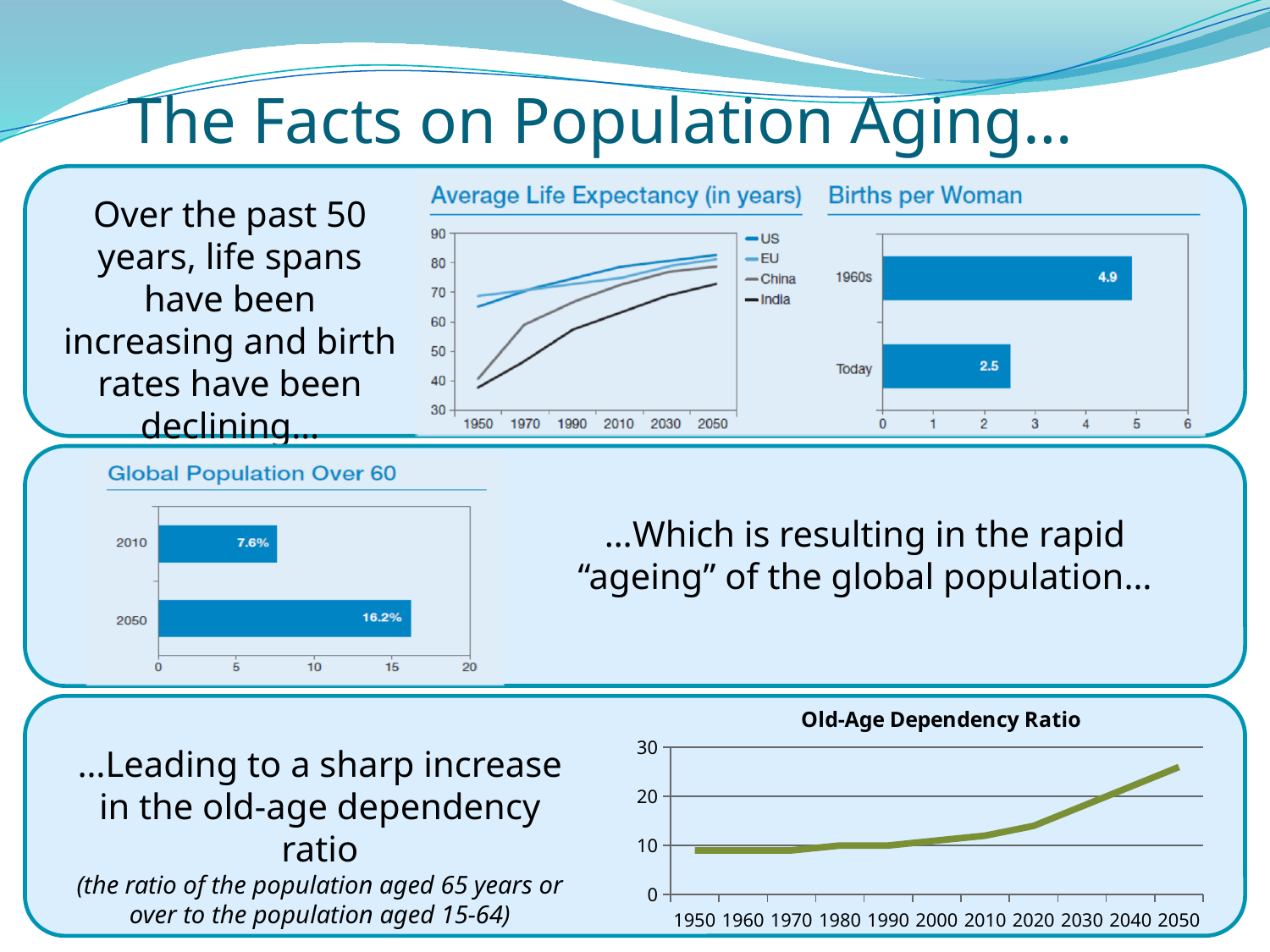
In the "Old-Age Dependency Ratio" chart, is the value for 2050 greater or less than 20? greater How many series does the legend of the "Average Life Expectancy (in years)" chart list? 4 In the "Old-Age Dependency Ratio" chart, do the values rise or fall from 1950 to 2050? rise In the "Global Population Over 60" chart, which year has the higher value, 2010 or 2050? 2050 In the "Births per Woman" chart, what is the value for the 1960s? 4.9 What kind of chart is the "Old-Age Dependency Ratio" chart? line chart In the "Average Life Expectancy (in years)" chart, which country has the lowest life expectancy in 1950? India In the "Births per Woman" chart, what is the value for Today? 2.5 In the "Global Population Over 60" chart, what is the value for 2050? 16.2% In the "Global Population Over 60" chart, what is the value for 2010? 7.6% In the "Births per Woman" chart, what is the difference between the 1960s value and the Today value? 2.4